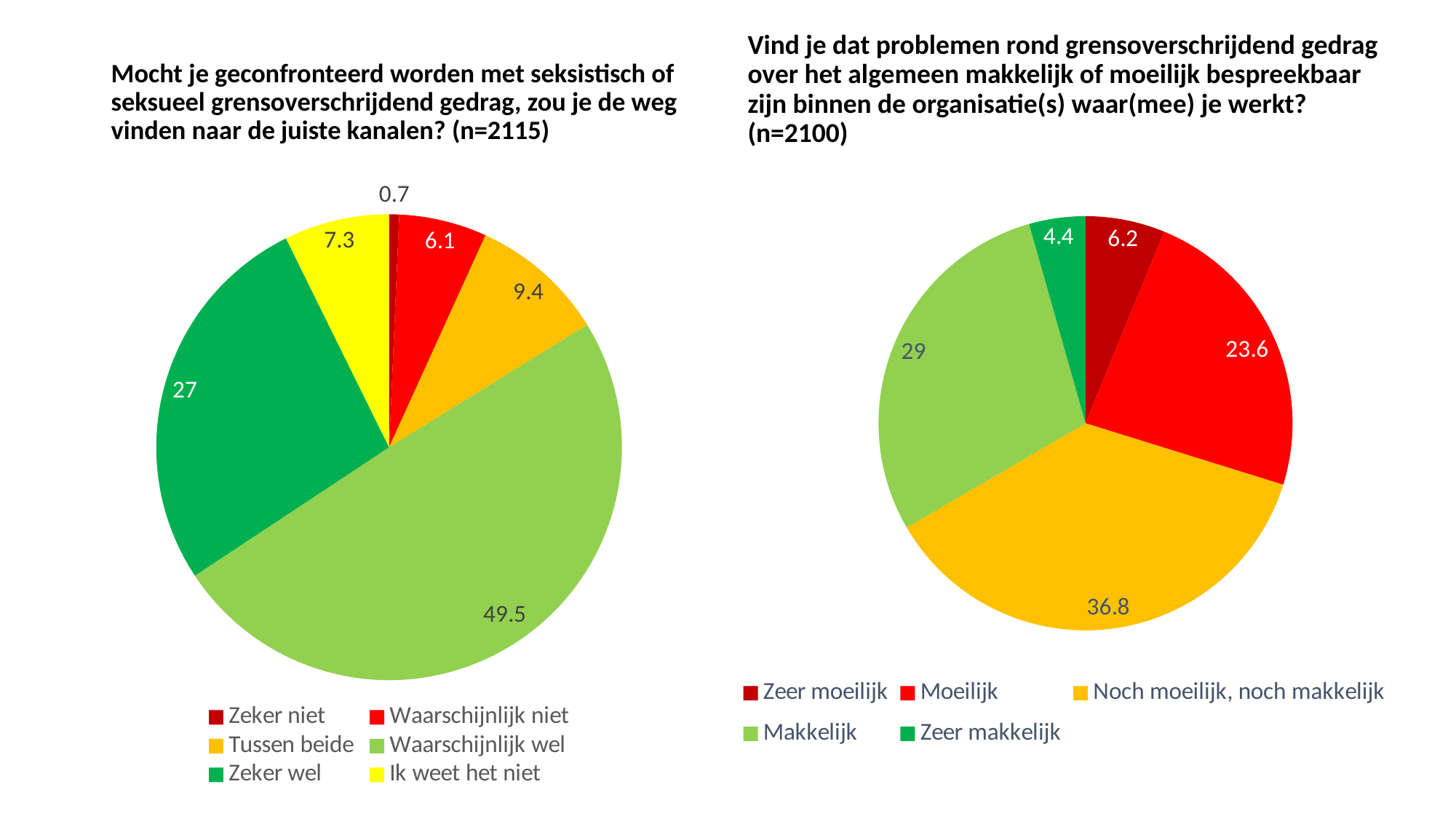
In the left pie chart, what is the value for 'Waarschijnlijk wel'? 49.5 In the right pie chart, what is the value for 'Zeer makkelijk'? 4.4 In the right pie chart, which is larger: 'Moeilijk' or 'Makkelijk'? Makkelijk In the left pie chart, what is the difference between 'Tussen beide' and 'Waarschijnlijk niet'? 3.3 How many categories does the legend of the left pie chart list? 6 In the left pie chart, which category has the largest slice? Waarschijnlijk wel In the left pie chart, which category has the smallest slice? Zeker niet In the right pie chart, what is the value for 'Noch moeilijk, noch makkelijk'? 36.8 In the left pie chart, what is the value for 'Zeker wel'? 27 What type of chart is used on the right side of the slide? Pie chart How many categories does the legend of the right pie chart list? 5 In the right pie chart, what is the difference between 'Makkelijk' and 'Moeilijk'? 5.4